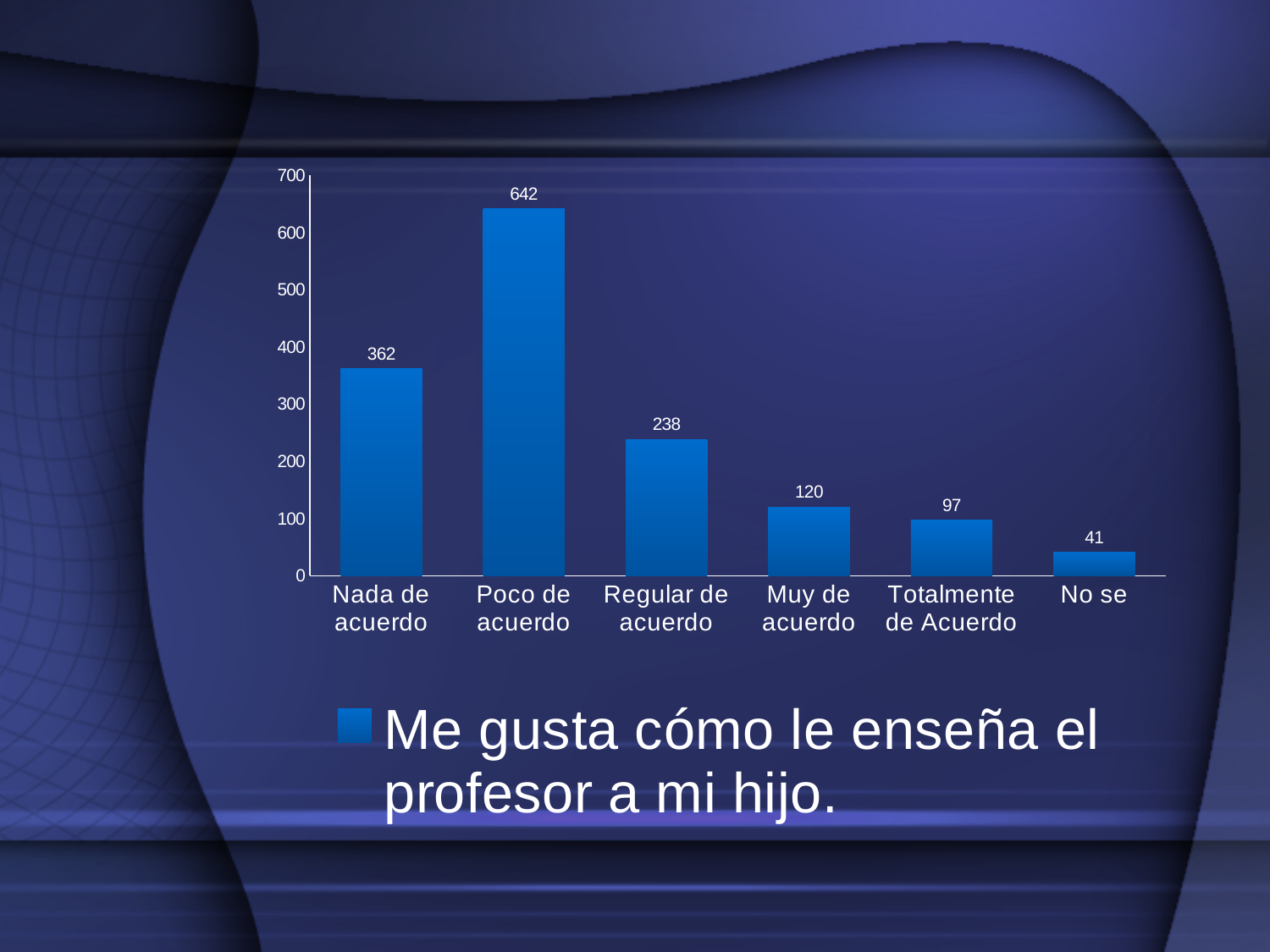
What is the difference between the values for "Regular de acuerdo" and "Muy de acuerdo"? 118 Which is larger, the value for "Regular de acuerdo" or the value for "Muy de acuerdo"? Regular de acuerdo What is the value for "Nada de acuerdo"? 362 What is the value for "Poco de acuerdo"? 642 Which category has the lowest value? No se What is the value for "Totalmente de Acuerdo"? 97 Which category has the highest value? Poco de acuerdo What kind of chart is shown on the slide? bar chart Is the value for "Muy de acuerdo" greater or less than 100? greater What is the value for "No se"? 41 What is the difference between the values for "Poco de acuerdo" and "Nada de acuerdo"? 280 How many categories are shown on the x axis? 6